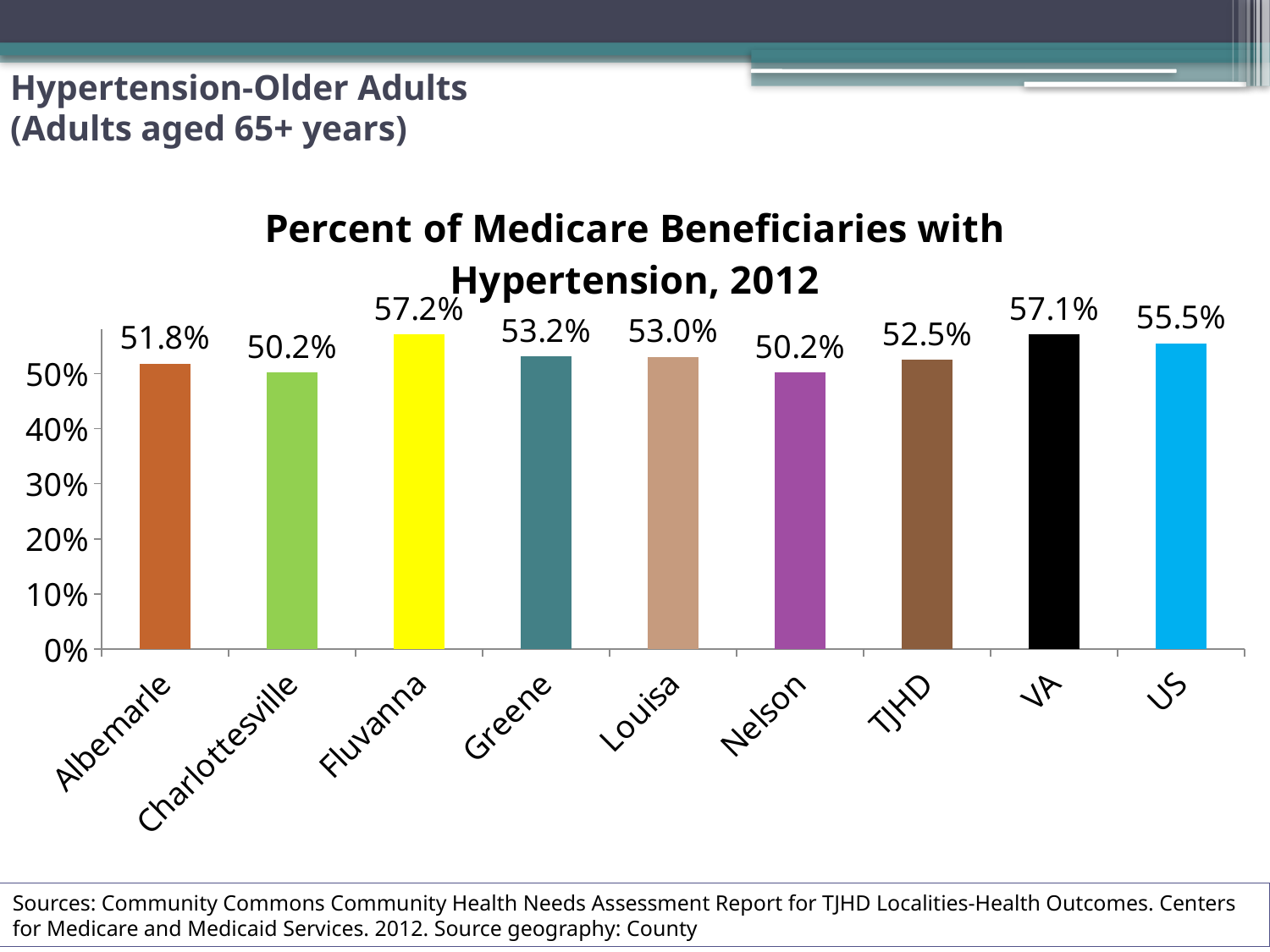
Which is larger, the value for VA or the value for Louisa? VA Which is larger, the value for Fluvanna or the value for Greene? Fluvanna What is the difference between the values for Albemarle and Charlottesville? 1.6% What is the value for Nelson? 50.2% What is the value for US? 55.5% What is the value for Fluvanna? 57.2% What kind of chart is shown on the slide? Bar chart What is the difference between the values for US and TJHD? 3.0% What is the value for Albemarle? 51.8% What is the value for TJHD? 52.5% Is the value for Greene greater or less than 40%? greater How many categories are shown on the x axis? 9